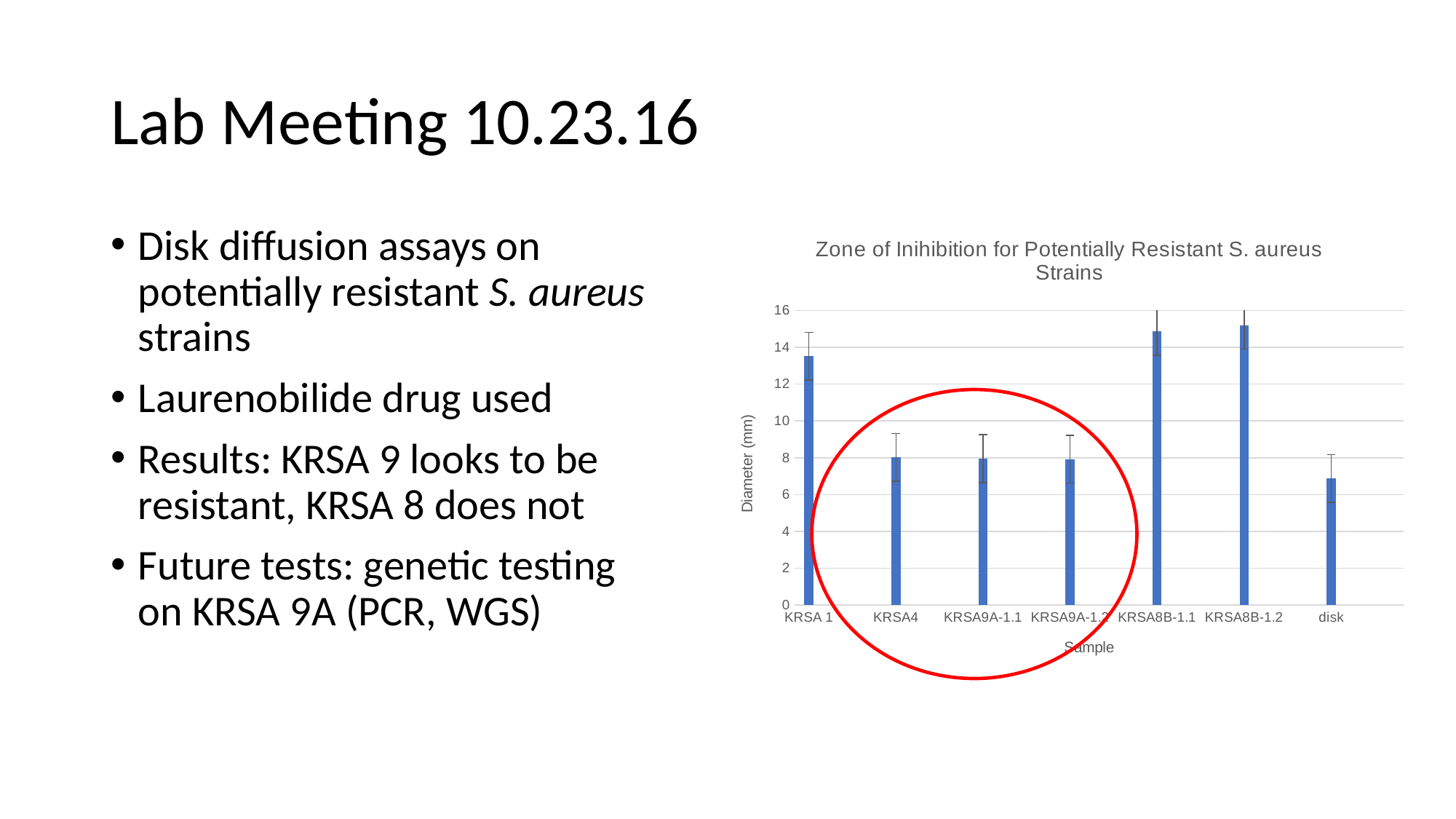
Is the value for KRSA 1 greater or less than 12? greater Is the value for KRSA8B-1.2 greater or less than 14? greater What is the title of the chart? Zone of Inihibition for Potentially Resistant S. aureus Strains Is the value for KRSA9A-1.1 greater or less than 10? less Which has a larger diameter, disk or KRSA8B-1.1? KRSA8B-1.1 Which sample has the lowest zone of inhibition diameter? disk What kind of chart is shown on the slide? bar chart How many samples are plotted on the chart? 7 Which has a larger diameter, KRSA 1 or KRSA4? KRSA 1 What is the label of the vertical axis of the chart? Diameter (mm)